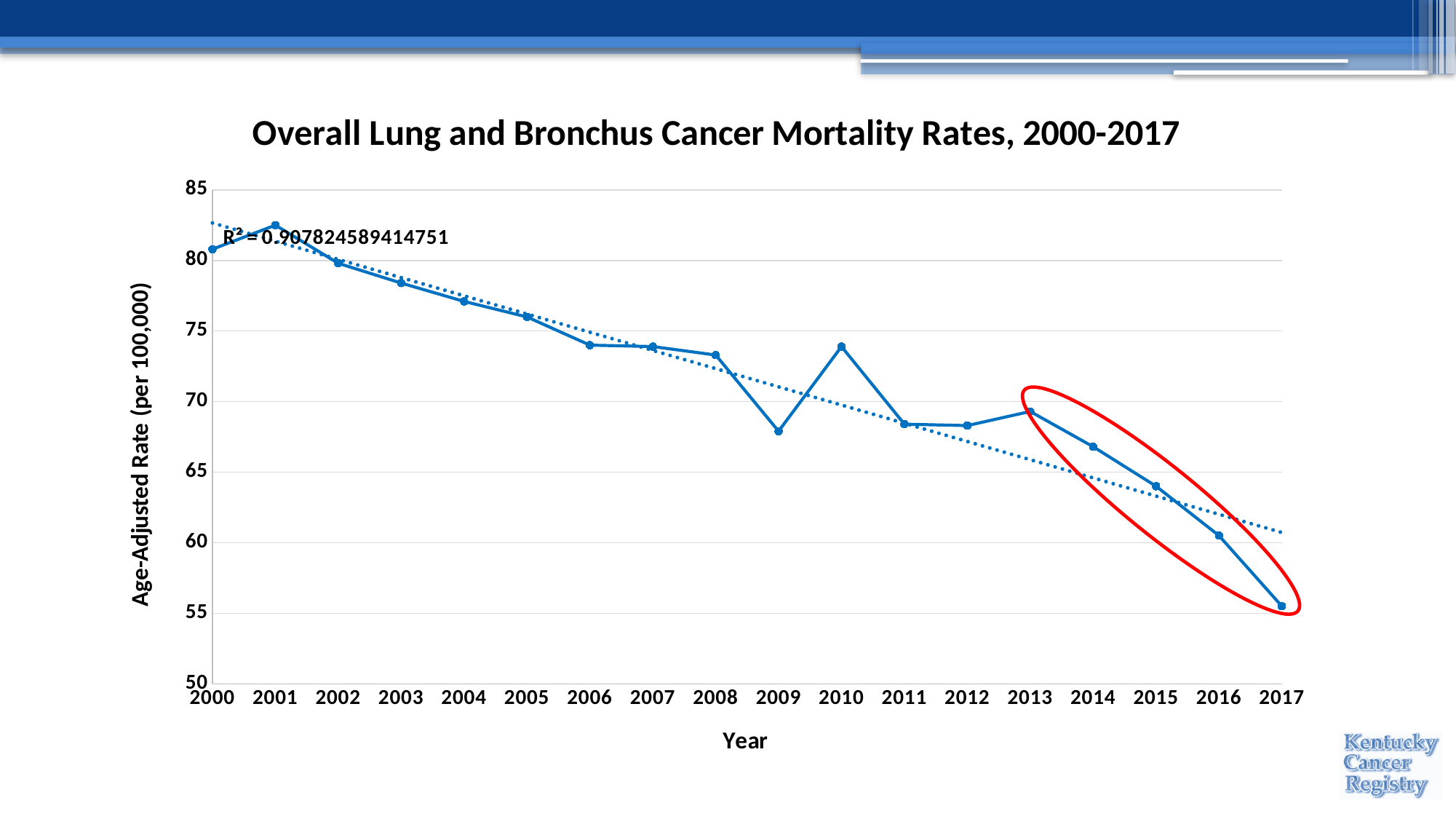
Which year has the lowest age-adjusted mortality rate? 2017 What is the title of the chart? Overall Lung and Bronchus Cancer Mortality Rates, 2000-2017 Which year has the larger mortality rate, 2009 or 2010? 2010 Is the value for 2010 greater or less than 70? greater Is the value for 2009 greater or less than 70? less Is the value for 2017 greater or less than 60? less What kind of chart is shown on the slide? Line chart How many years (data points) are plotted on the chart? 18 Overall, do the mortality rates rise or fall from 2000 to 2017? Fall Which year has the highest age-adjusted mortality rate? 2001 What R² value is shown for the trendline on the chart? R² = 0.907824589414751